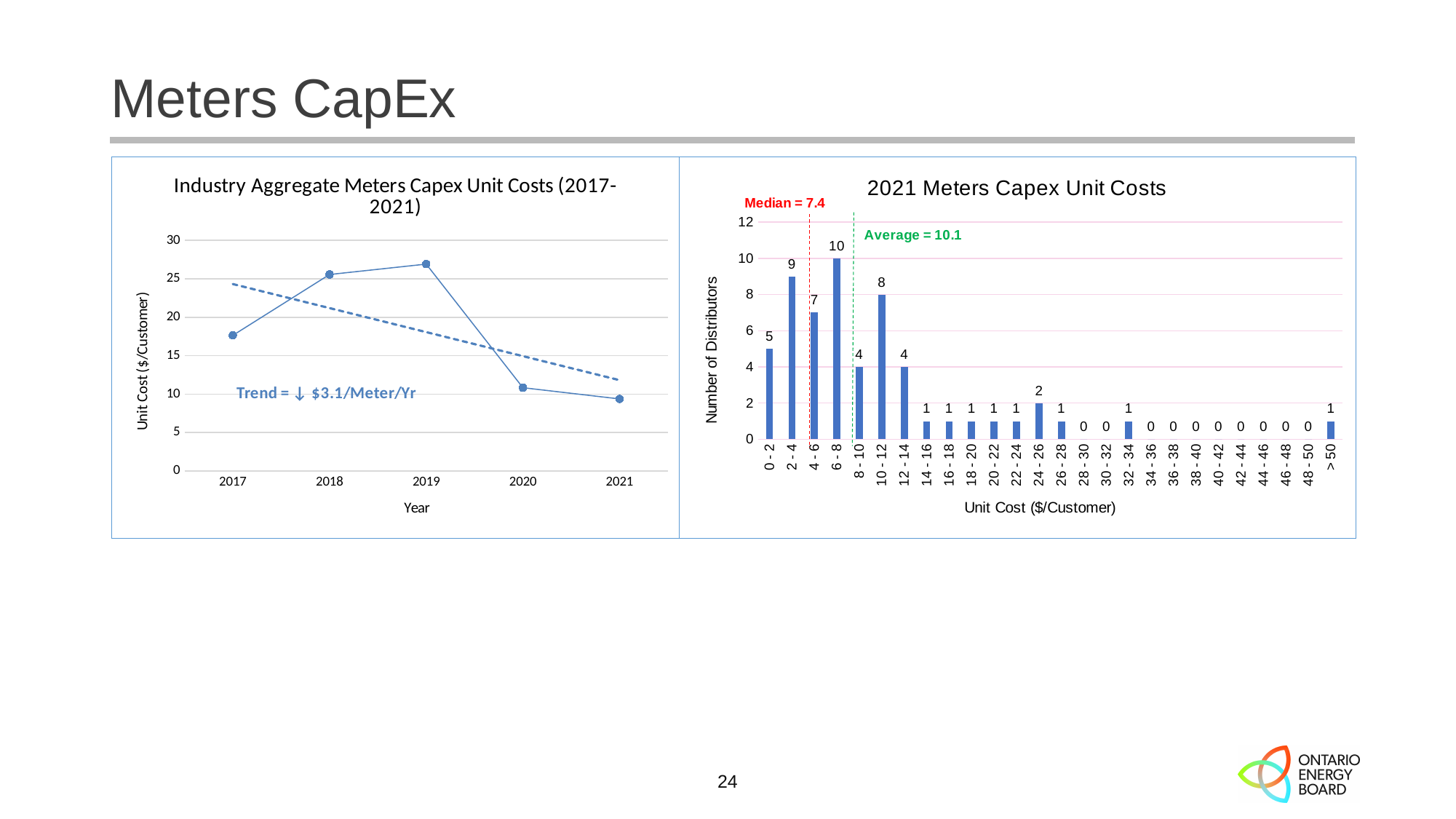
On the left chart (Industry Aggregate Meters Capex Unit Costs), is the unit cost for 2021 greater or less than 10? less On the right chart (2021 Meters Capex Unit Costs), how many distributors are in the 10 - 12 bin? 8 On the right chart (2021 Meters Capex Unit Costs), which unit cost bin has the highest number of distributors? 6 - 8 What kind of chart is the left chart, Industry Aggregate Meters Capex Unit Costs (2017-2021)? line chart On the right chart (2021 Meters Capex Unit Costs), what is the difference between the number of distributors in the 10 - 12 bin and the 12 - 14 bin? 4 On the left chart (Industry Aggregate Meters Capex Unit Costs), which year has the lowest unit cost? 2021 On the right chart (2021 Meters Capex Unit Costs), how many distributors are in the 6 - 8 unit cost bin? 10 On the right chart (2021 Meters Capex Unit Costs), what is the average value shown? 10.1 On the right chart (2021 Meters Capex Unit Costs), how many distributors are in the > 50 bin? 1 On the right chart (2021 Meters Capex Unit Costs), what is the median value shown? 7.4 On the left chart (Industry Aggregate Meters Capex Unit Costs), which year has the highest unit cost? 2019 On the right chart (2021 Meters Capex Unit Costs), which bin has more distributors, 2 - 4 or 4 - 6? 2 - 4